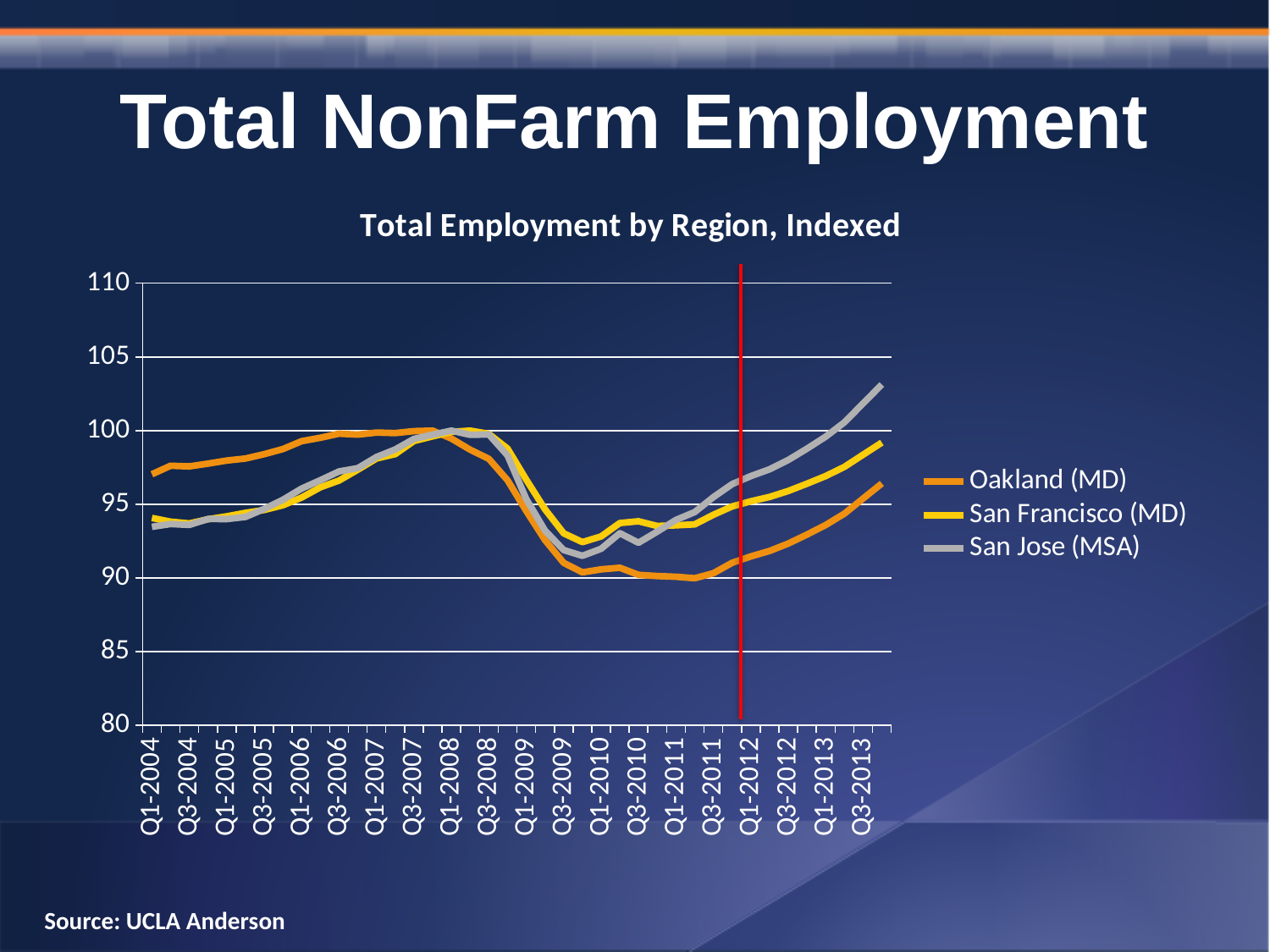
What kind of chart is shown on the slide? Line chart Does the San Jose (MSA) line rise or fall between Q1-2012 and Q3-2013? Rise At Q1-2004, which is higher: Oakland (MD) or San Jose (MSA)? Oakland (MD) Which series is lowest at Q1-2011? Oakland (MD) Is the value for San Jose (MSA) at Q3-2013 greater or less than 100? greater What is the title of the chart? Total Employment by Region, Indexed At Q3-2013, which is higher: San Francisco (MD) or Oakland (MD)? San Francisco (MD) Is the value for Oakland (MD) at Q1-2004 greater or less than 95? greater How many series does the chart's legend list? 3 Does the Oakland (MD) line rise or fall between Q1-2008 and Q3-2009? Fall Is the value for Oakland (MD) at Q1-2011 greater or less than 95? less Which series is highest at Q3-2013? San Jose (MSA)